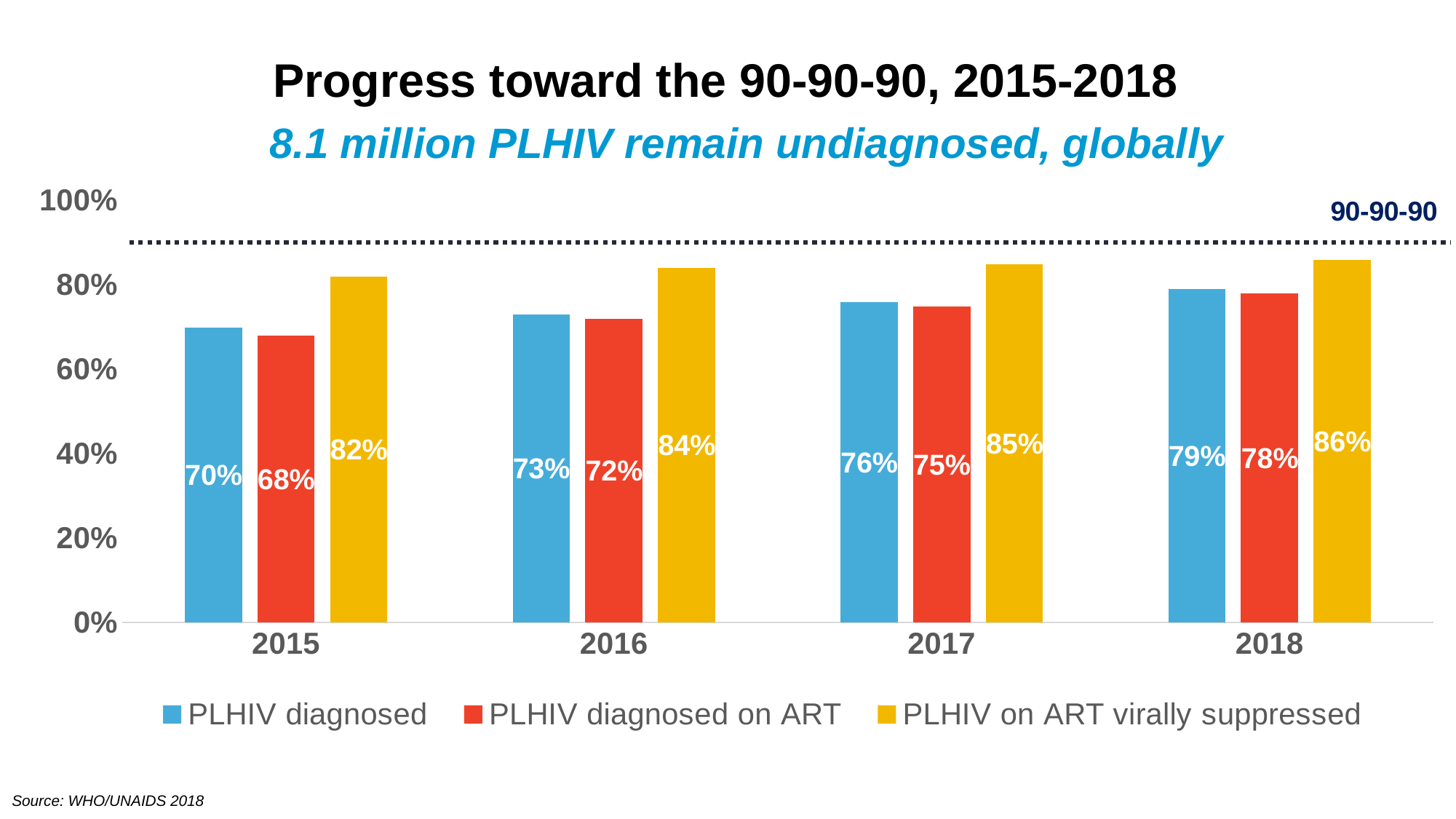
What is the value for PLHIV diagnosed on ART in 2017? 75% Is the value for PLHIV on ART virally suppressed in 2017 greater or less than 90%? less In which year is PLHIV diagnosed highest? 2018 How many series does the legend list? 3 What is the value for PLHIV diagnosed in 2015? 70% How many years are shown on the x axis? 4 Which is larger in 2016: PLHIV diagnosed or PLHIV diagnosed on ART? PLHIV diagnosed Does PLHIV on ART virally suppressed rise or fall from 2015 to 2018? rise What is the value for PLHIV on ART virally suppressed in 2018? 86% In which year is PLHIV diagnosed on ART lowest? 2015 What kind of chart is shown? bar chart What is the difference between PLHIV diagnosed in 2018 and in 2015? 9%